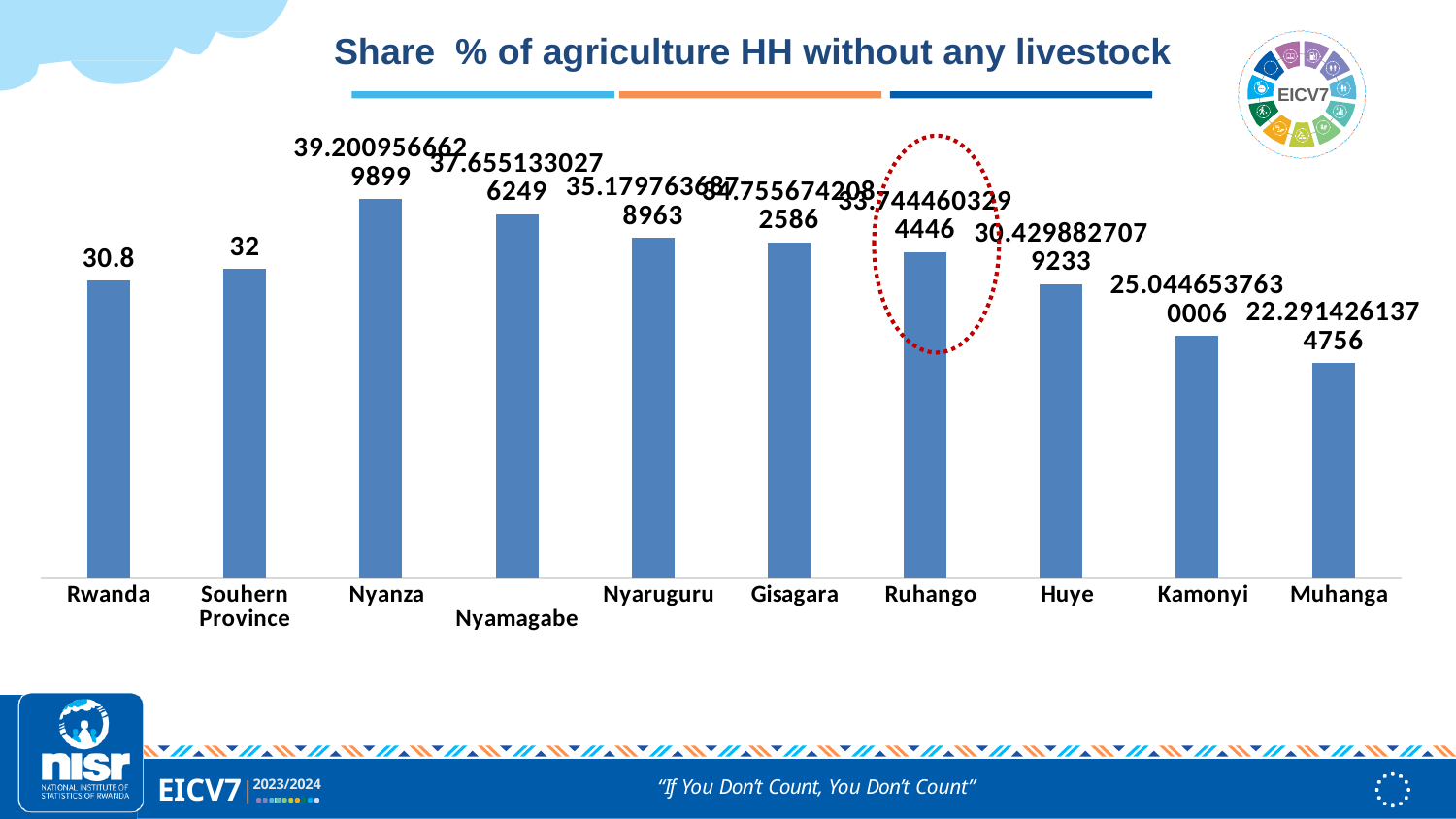
What is the value shown for Rwanda? 30.8 How many categories are shown on the x axis? 10 What is the difference between the values for Souhern Province and Rwanda? 1.2 Which has a larger value, Nyanza or Nyamagabe? Nyanza Which category's bar is highlighted with a red dotted circle? Ruhango Which category has the highest share of agriculture households without any livestock? Nyanza What is the value shown for Souhern Province? 32 Which category has the lowest share of agriculture households without any livestock? Muhanga What is the value shown for Nyanza? 39.2009566629899 What is the value shown for Kamonyi? 25.0446537630006 What is the value shown for Muhanga? 22.2914261374756 What kind of chart is shown on the slide? Bar chart